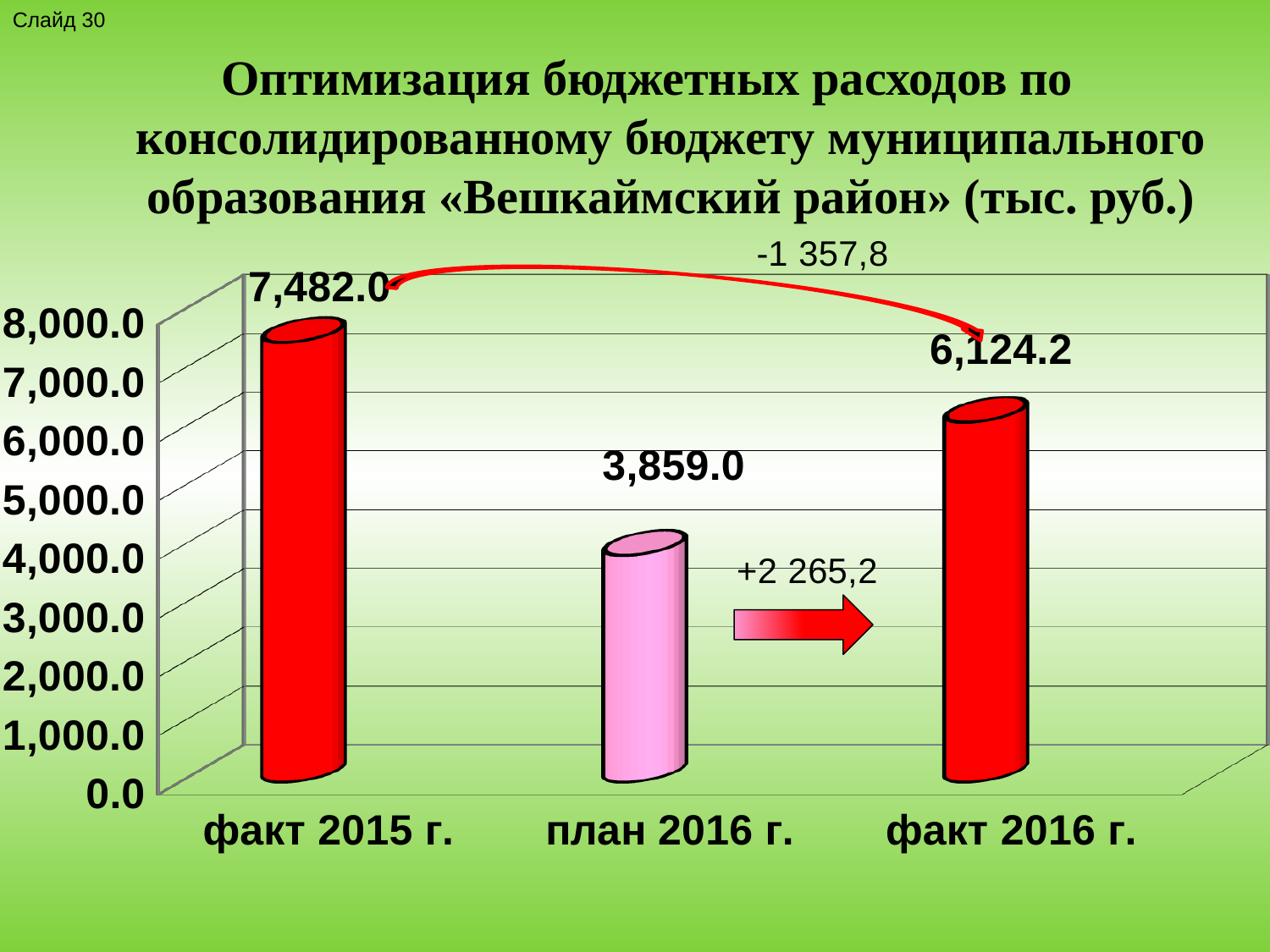
Which is larger, the value for план 2016 г. or the value for факт 2016 г.? факт 2016 г. What is the value for план 2016 г.? 3,859.0 What colour is the bar for план 2016 г.? pink What is the difference between the values for факт 2015 г. and факт 2016 г.? 1,357.8 What is the value for факт 2015 г.? 7,482.0 What is the difference between the values for факт 2016 г. and план 2016 г.? 2,265.2 What kind of chart is shown on the slide? bar chart What is the value for факт 2016 г.? 6,124.2 How many categories are shown on the chart? 3 Which category has the highest value? факт 2015 г. Which category has the lowest value? план 2016 г. Is the value for план 2016 г. greater or less than 4,000.0? less